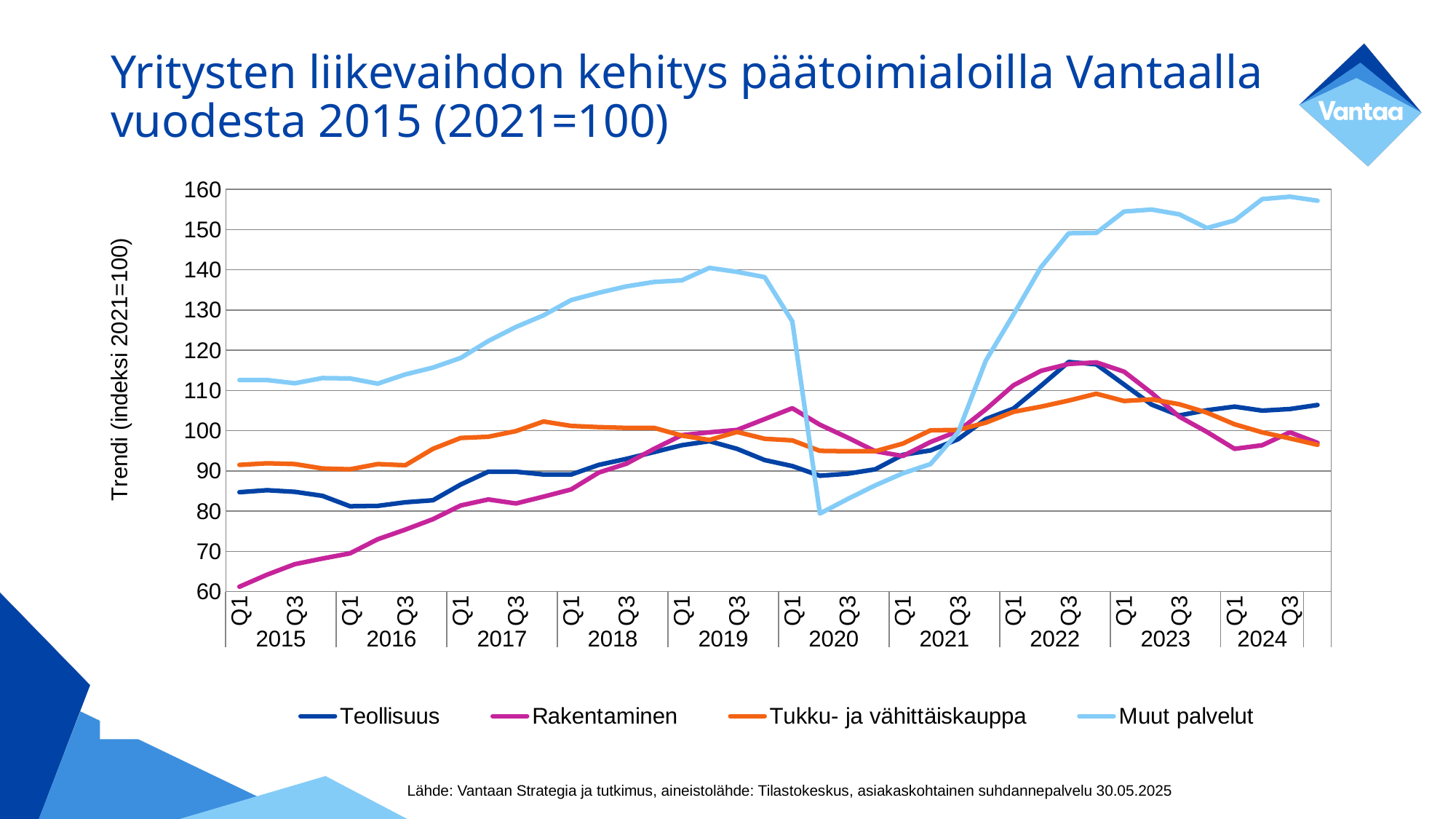
Which series has the highest value at Q3 2024? Muut palvelut Is the lowest value of Muut palvelut in 2020 greater or less than 90? less Is the value for Muut palvelut at Q3 2024 greater or less than 150? greater How many years are labelled along the x axis? 10 At Q1 2015, which is higher: Teollisuus or Rakentaminen? Teollisuus Which series has the lowest value at Q1 2015? Rakentaminen Is the value for Teollisuus at Q1 2015 greater or less than 90? less Which series are listed in the legend? Teollisuus, Rakentaminen, Tukku- ja vähittäiskauppa, Muut palvelut What is the label of the vertical axis? Trendi (indeksi 2021=100) What kind of chart is shown on the slide? line chart How many series does the legend list? 4